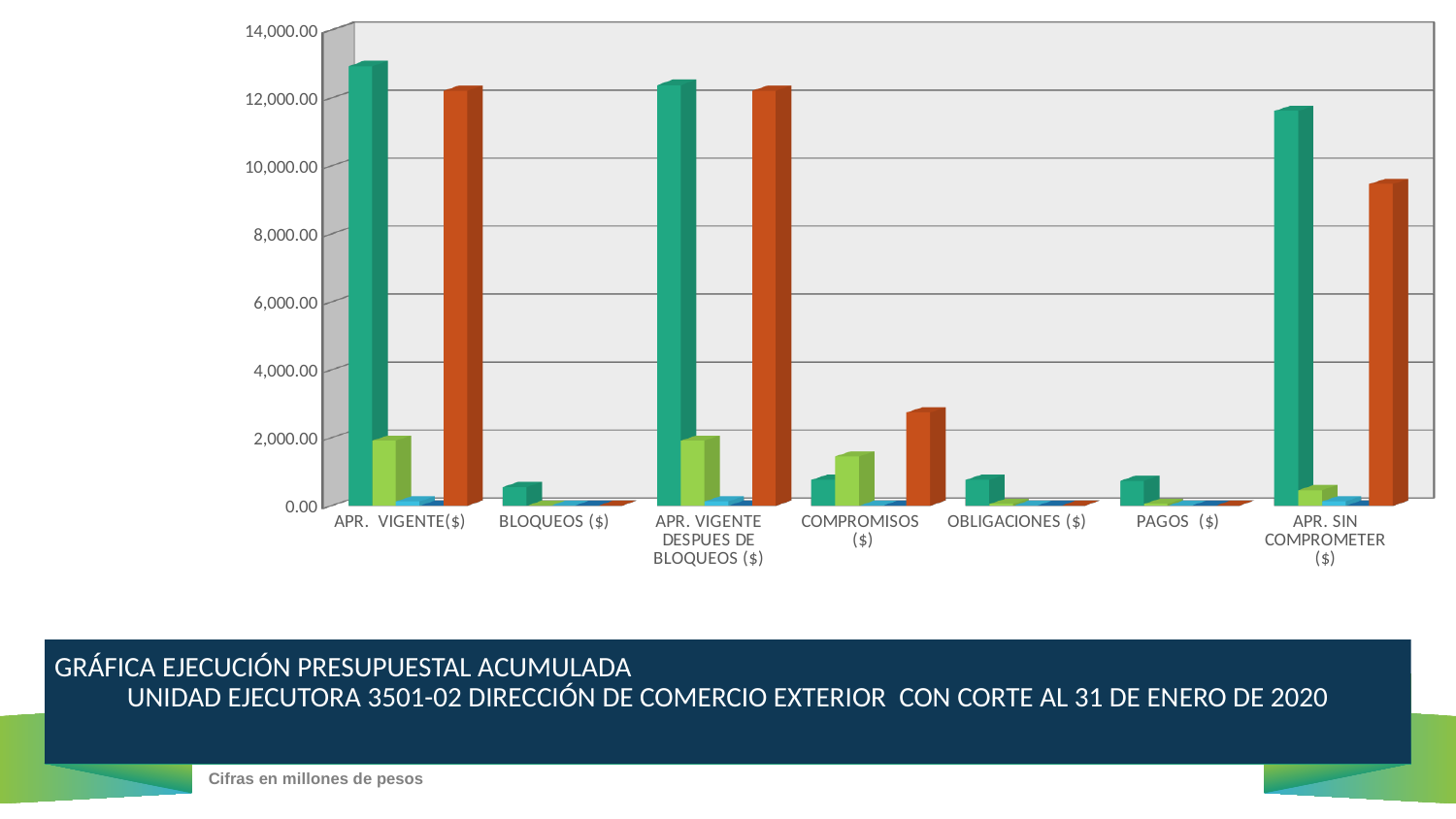
What kind of chart is shown on the slide? bar chart According to the note on the slide, in what units are the chart figures expressed? Millones de pesos Is the orange bar for APR. SIN COMPROMETER ($) greater or less than 10,000.00? less Is the tallest (teal) bar for APR. VIGENTE($) greater or less than 12,000.00? greater Which is larger: the orange bar for COMPROMISOS ($) or the orange bar for OBLIGACIONES ($)? COMPROMISOS ($) Which is larger: the teal bar for APR. VIGENTE($) or the teal bar for APR. SIN COMPROMETER ($)? APR. VIGENTE($) How many categories are shown along the x axis of the chart? 7 Is the teal bar for APR. SIN COMPROMETER ($) greater or less than 10,000.00? greater Which category has the tallest bar in the chart? APR. VIGENTE($) What is the highest tick value shown on the vertical axis of the chart? 14,000.00